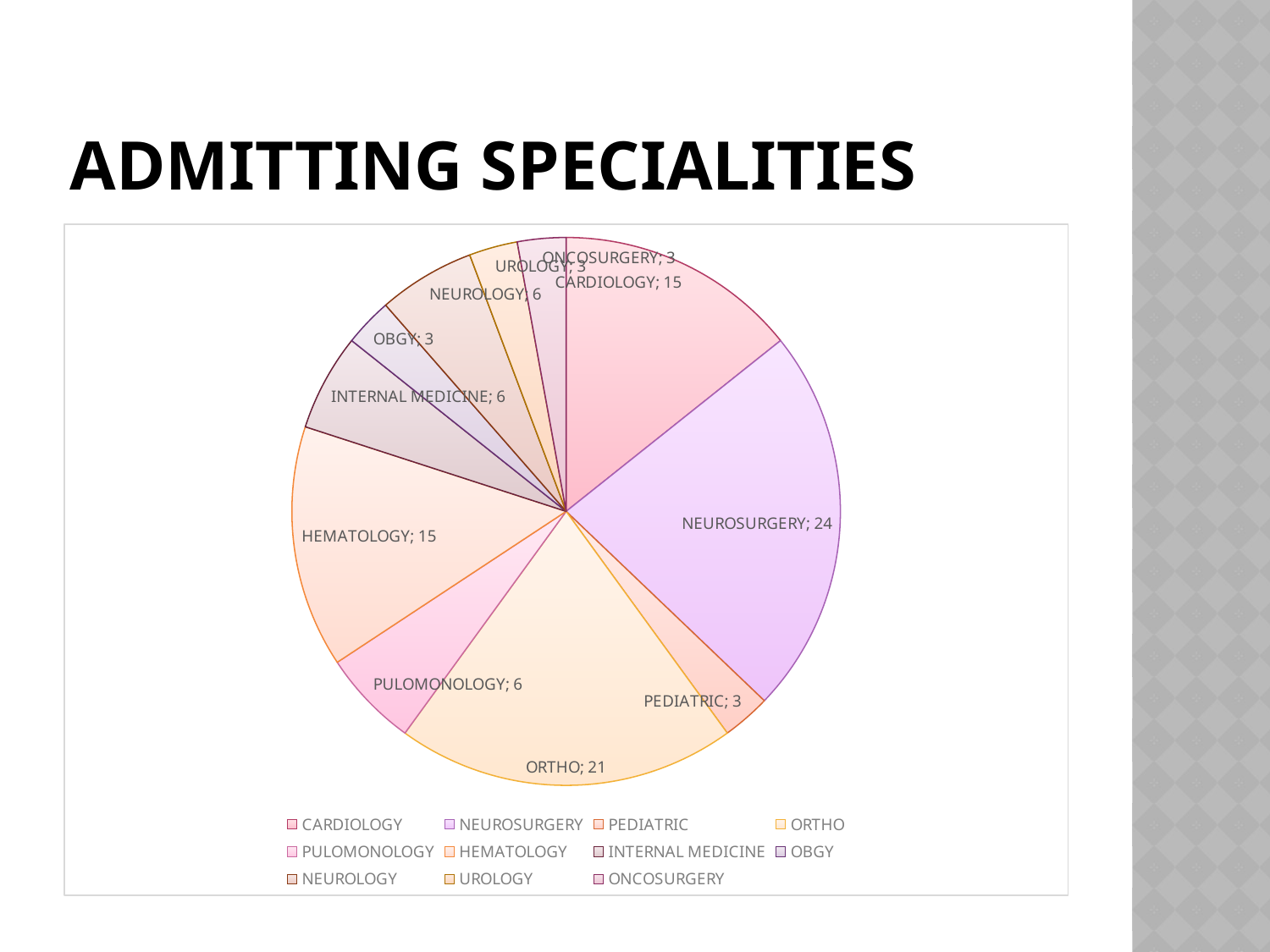
How many slices does the pie chart have? 11 What is the difference between the values for HEMATOLOGY and NEUROLOGY? 9 Which speciality has the largest slice of the pie? NEUROSURGERY What share of the pie does ORTHO represent? 20% What kind of chart is shown on the slide? pie chart What is the value for ORTHO? 21 What is the value for INTERNAL MEDICINE? 6 What is the value for NEUROSURGERY? 24 Which is larger, the value for CARDIOLOGY or the value for PULOMONOLOGY? CARDIOLOGY What is the difference between the values for NEUROSURGERY and ORTHO? 3 What is the value for HEMATOLOGY? 15 What is the title of the slide containing the chart? ADMITTING SPECIALITIES